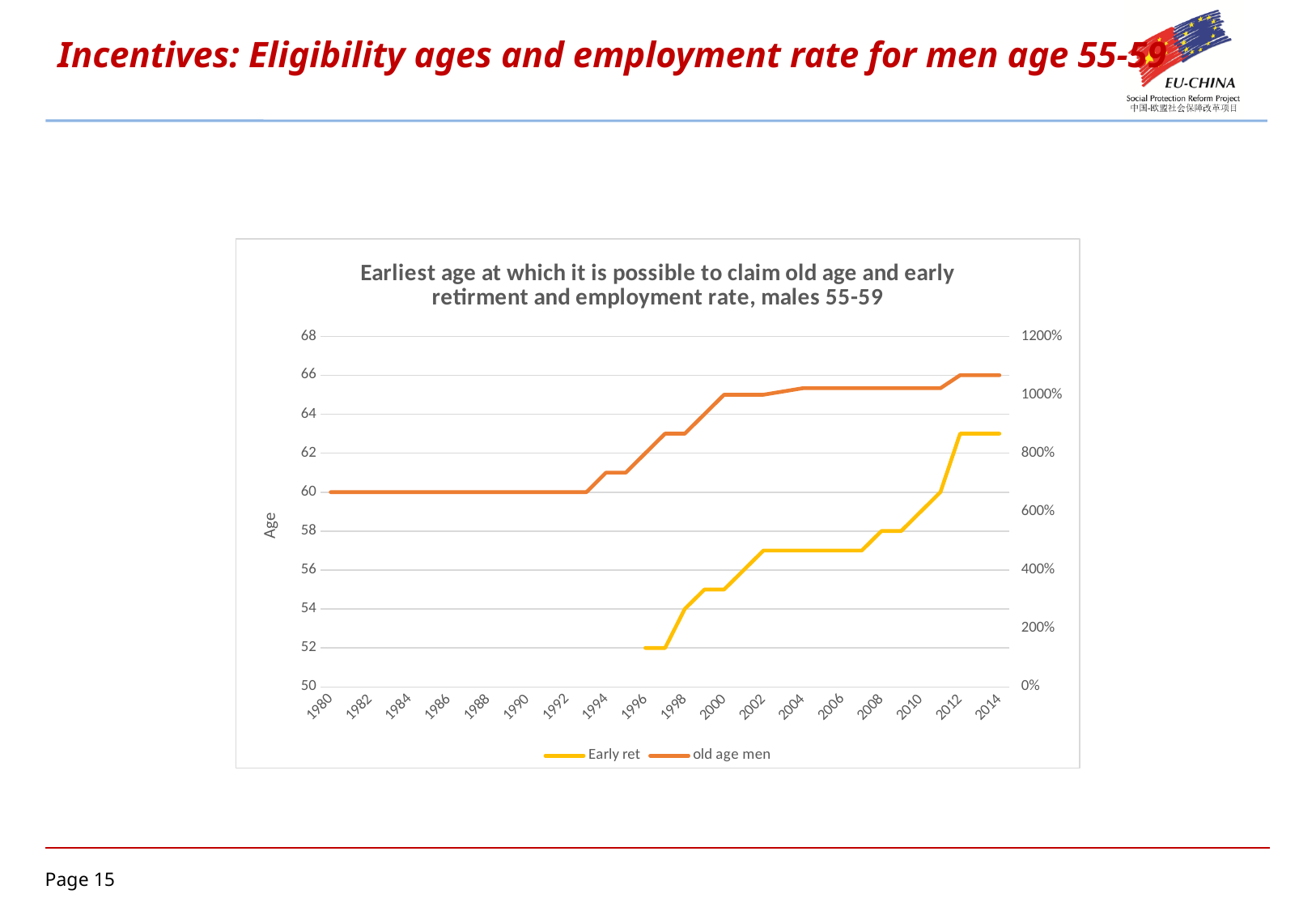
Does the 'Early ret' series rise or fall from 1996 to 2014? rise What is the value of the 'Early ret' series in 1996? 52 What is the label of the left vertical axis? Age What kind of chart is shown on the slide? line chart Is the value for 'old age men' in 2000 greater or less than 64? greater What is the title of the chart? Earliest age at which it is possible to claim old age and early retirment and employment rate, males 55-59 What is the value of the 'Early ret' series in 2008? 58 What is the value of the 'old age men' series in 1980? 60 How many series does the legend list? 2 Is the value for 'Early ret' in 2014 greater or less than 62? greater Which series has the higher value in 2014, 'Early ret' or 'old age men'? old age men What is the value of the 'old age men' series in 2014? 66